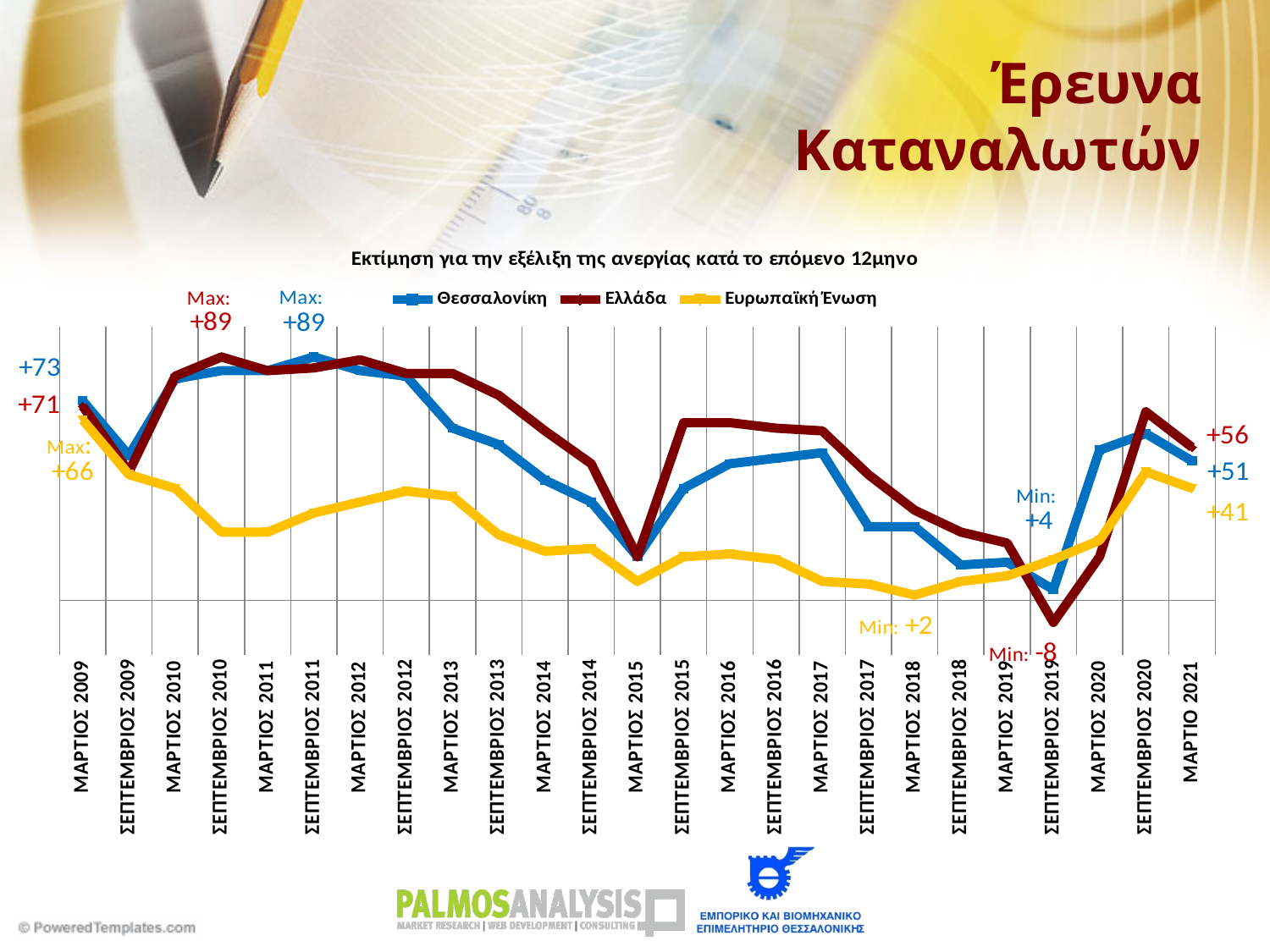
What is the value for Ευρωπαϊκή Ένωση in ΜΑΡΤΙΟ 2021? +41 Which series has the higher value in ΜΑΡΤΙΟ 2021, Θεσσαλονίκη or Ευρωπαϊκή Ένωση? Θεσσαλονίκη How many time points are shown on the x axis of the chart? 25 How many series does the chart legend list? 3 What kind of chart is shown on the slide? line chart What is the minimum value reached by the Ελλάδα series, as labelled on the chart? -8 What is the difference between the Ελλάδα and Θεσσαλονίκη values in ΜΑΡΤΙΟ 2021? 5 What is the title of the chart? Εκτίμηση για την εξέλιξη της ανεργίας κατά το επόμενο 12μηνο What is the minimum value reached by the Ευρωπαϊκή Ένωση series, as labelled on the chart? +2 What is the value for Θεσσαλονίκη in ΜΑΡΤΙΟΣ 2009? +73 What is the value for Ελλάδα in ΜΑΡΤΙΟ 2021? +56 What is the maximum value reached by the Ελλάδα series, as labelled on the chart? +89